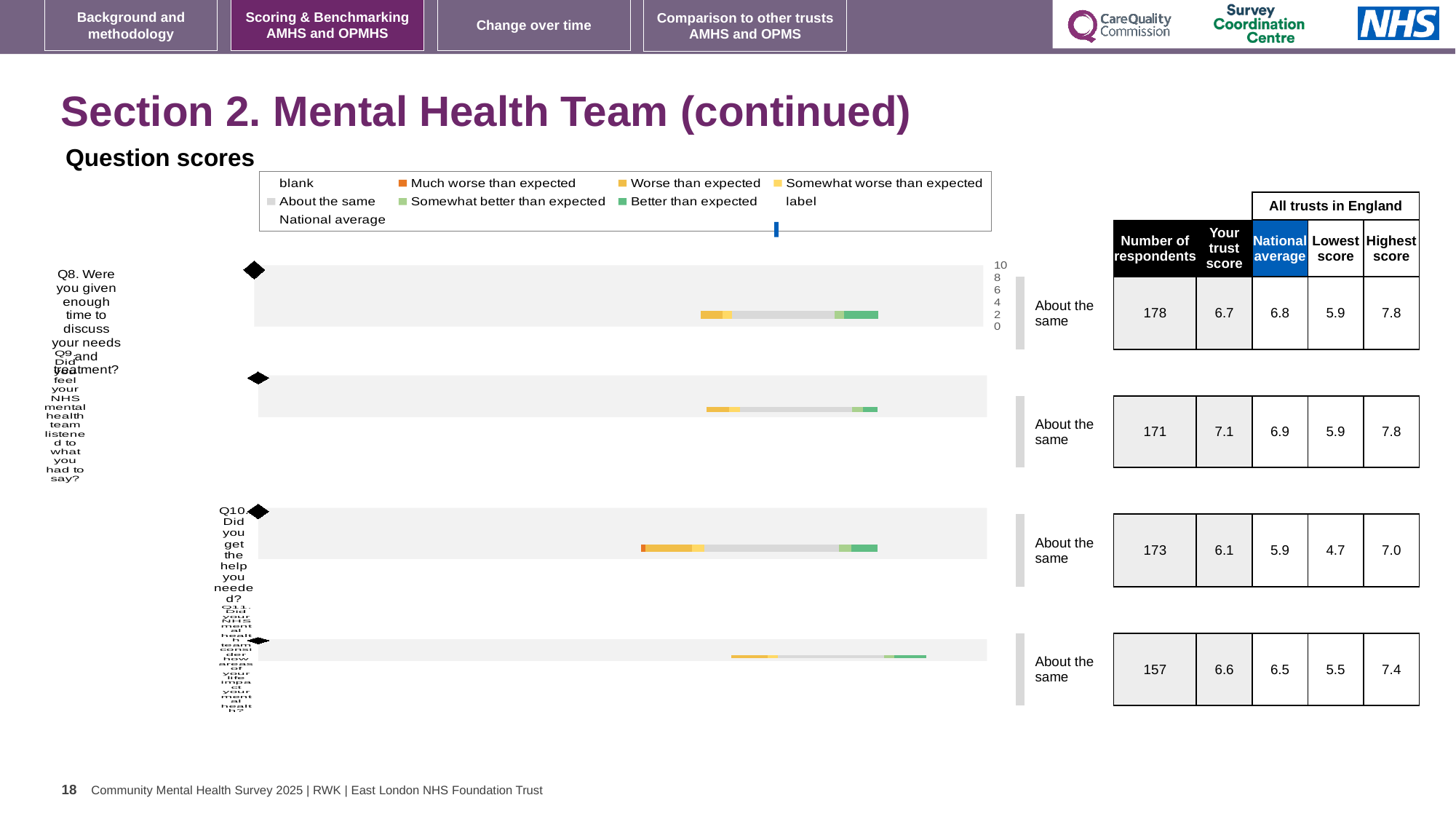
For Q8, which is larger in the table: the trust score or the national average? national average In the legend, what colour represents 'Much worse than expected'? orange In the table next to the Q11 chart, what is the highest score among all trusts in England? 7.4 In the table next to the Q8 chart, what is the number of respondents? 178 What kind of chart is used to show the question scores for Q8 to Q11? bar chart In the table next to the Q10 chart, what is the national average score? 5.9 In the table next to the Q9 chart, what is the 'Your trust score' value? 7.1 What comparison label is shown to the right of the Q10 chart? About the same Which question (Q8, Q9, Q10 or Q11) has the lowest 'Your trust score' in the table? Q10 Which question (Q8, Q9, Q10 or Q11) has the highest 'Your trust score' in the table? Q9 How many questions (Q8 to Q11) have a bar chart on the slide? 4 For Q10, what is the difference between the highest score (7.0) and the lowest score (4.7) in the table? 2.3